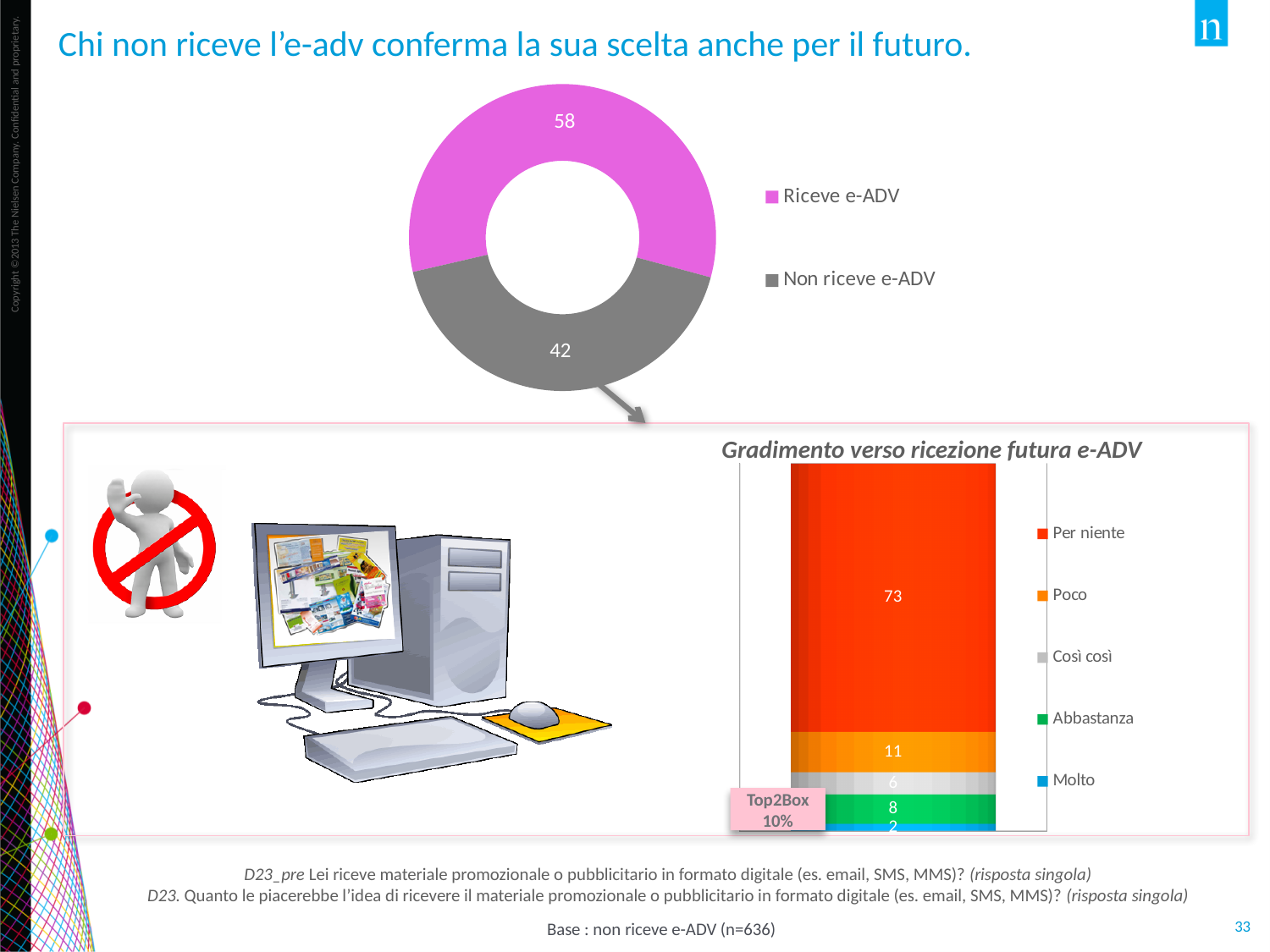
In the chart titled 'Gradimento verso ricezione futura e-ADV', what is the value for Per niente? 73 In the chart titled 'Gradimento verso ricezione futura e-ADV', what is the value for Molto? 2 In the donut chart at the top of the slide, what is the difference between the Riceve e-ADV and Non riceve e-ADV values? 16 In the chart titled 'Gradimento verso ricezione futura e-ADV', which category has the highest value? Per niente In the donut chart at the top of the slide, what is the value for Riceve e-ADV? 58 In the donut chart at the top of the slide, what is the value for Non riceve e-ADV? 42 In the donut chart at the top of the slide, which segment is larger, Riceve e-ADV or Non riceve e-ADV? Riceve e-ADV In the chart titled 'Gradimento verso ricezione futura e-ADV', which category has the lowest value? Molto In the chart titled 'Gradimento verso ricezione futura e-ADV', what is the total of the stacked bar? 100 How many entries does the legend of the donut chart at the top of the slide list? 2 What type of chart is the chart titled 'Gradimento verso ricezione futura e-ADV'? Stacked bar chart In the chart titled 'Gradimento verso ricezione futura e-ADV', what is the value for Poco? 11